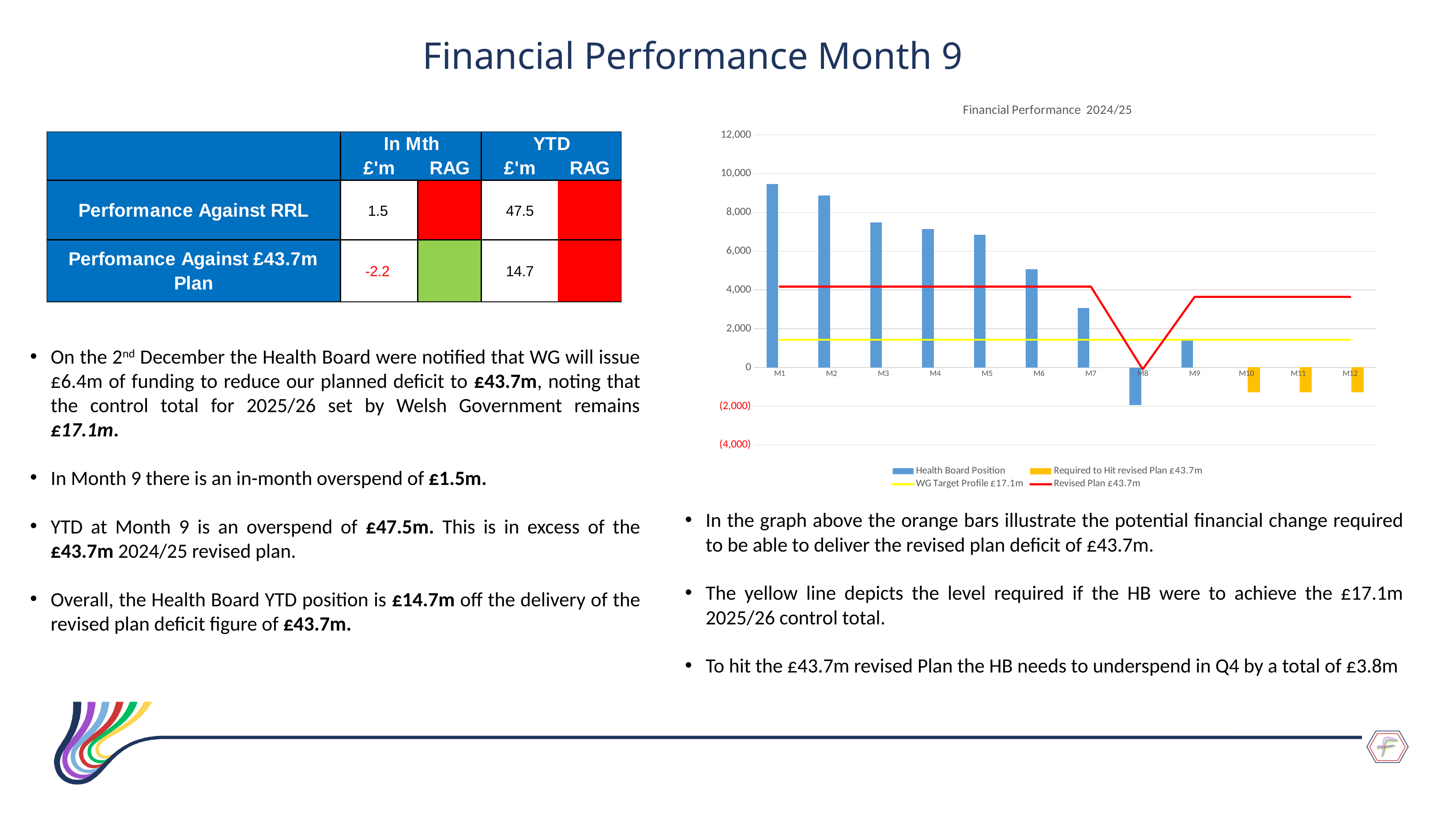
How many months are shown on the x axis of the Financial Performance 2024/25 chart? 12 In the Financial Performance 2024/25 chart, is the Health Board Position for M3 greater or less than 8,000? less In the Financial Performance 2024/25 chart, which series is shown by the orange bars? Required to Hit revised Plan £43.7m What kind of chart is the Financial Performance 2024/25 chart? combination bar and line chart In the Financial Performance 2024/25 chart, is the Health Board Position for M9 greater or less than 2,000? less In the Financial Performance 2024/25 chart, which is larger, the Health Board Position for M2 or for M6? M2 In the Financial Performance 2024/25 chart, do the Health Board Position bars generally rise or fall from M1 to M8? fall How many series does the legend of the Financial Performance 2024/25 chart list? 4 In the Financial Performance 2024/25 chart, which month has the highest Health Board Position bar? M1 In the Financial Performance 2024/25 chart, which month has the lowest Health Board Position bar? M8 In the Financial Performance 2024/25 chart, is the Health Board Position for M7 greater or less than 4,000? less